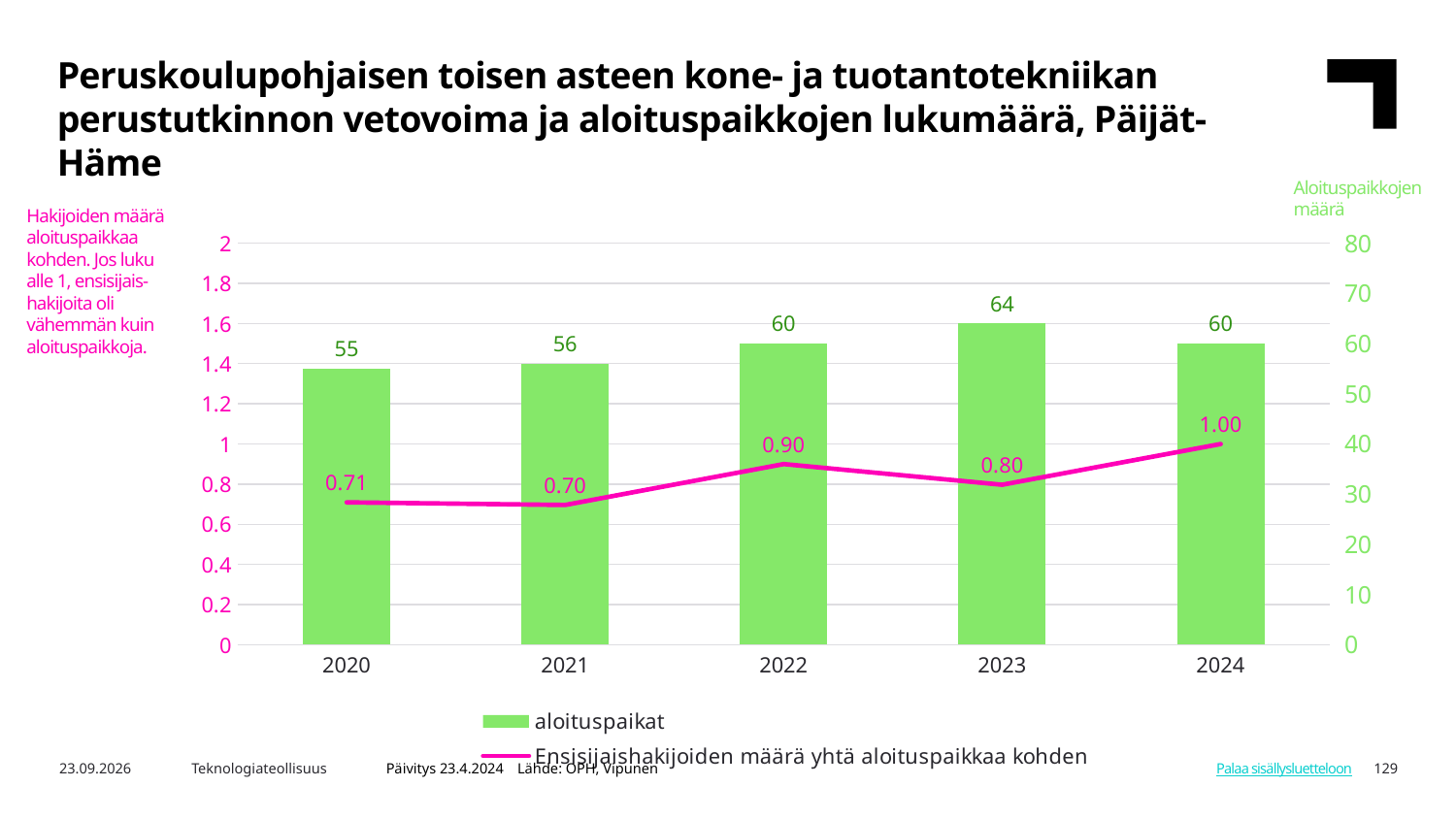
Does the value of Ensisijaishakijoiden määrä yhtä aloituspaikkaa kohden rise or fall from 2021 to 2022? rise What kind of chart is used for the aloituspaikat series? bar chart In which year is aloituspaikat highest? 2023 What is the difference in aloituspaikat between 2023 and 2020? 9 How many years are shown on the x axis? 5 Which year has a higher value of Ensisijaishakijoiden määrä yhtä aloituspaikkaa kohden, 2023 or 2024? 2024 What is the value of aloituspaikat in 2020? 55 How many series does the legend list? 2 What is the value of aloituspaikat in 2023? 64 What is the value of Ensisijaishakijoiden määrä yhtä aloituspaikkaa kohden in 2022? 0.90 What colour are the aloituspaikat bars? green In which year is Ensisijaishakijoiden määrä yhtä aloituspaikkaa kohden lowest? 2021